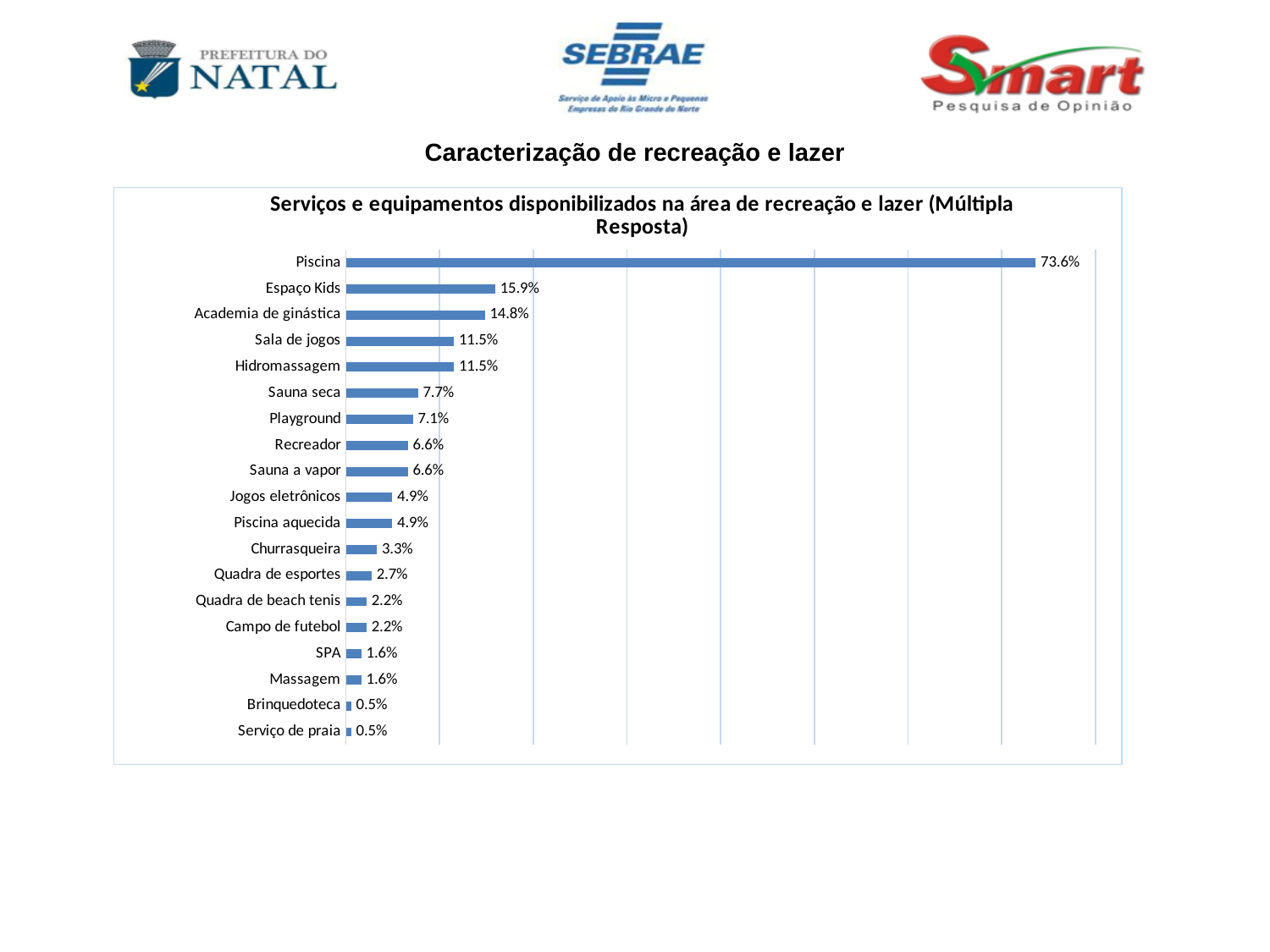
What percentage is shown for Churrasqueira? 3.3% What is the difference between the values for Sauna seca and Playground? 0.6% Which is larger, the value for Espaço Kids or the value for Sala de jogos? Espaço Kids Which category has the highest value? Piscina What is the title of the chart? Serviços e equipamentos disponibilizados na área de recreação e lazer (Múltipla Resposta) What percentage is shown for Piscina? 73.6% How many categories are shown in the chart? 19 What is the value for Quadra de esportes? 2.7% What kind of chart is shown on the slide? Bar chart What is the difference between the values for Piscina and Espaço Kids? 57.7% Which is larger, the value for Jogos eletrônicos or the value for Churrasqueira? Jogos eletrônicos What is the value for Academia de ginástica? 14.8%